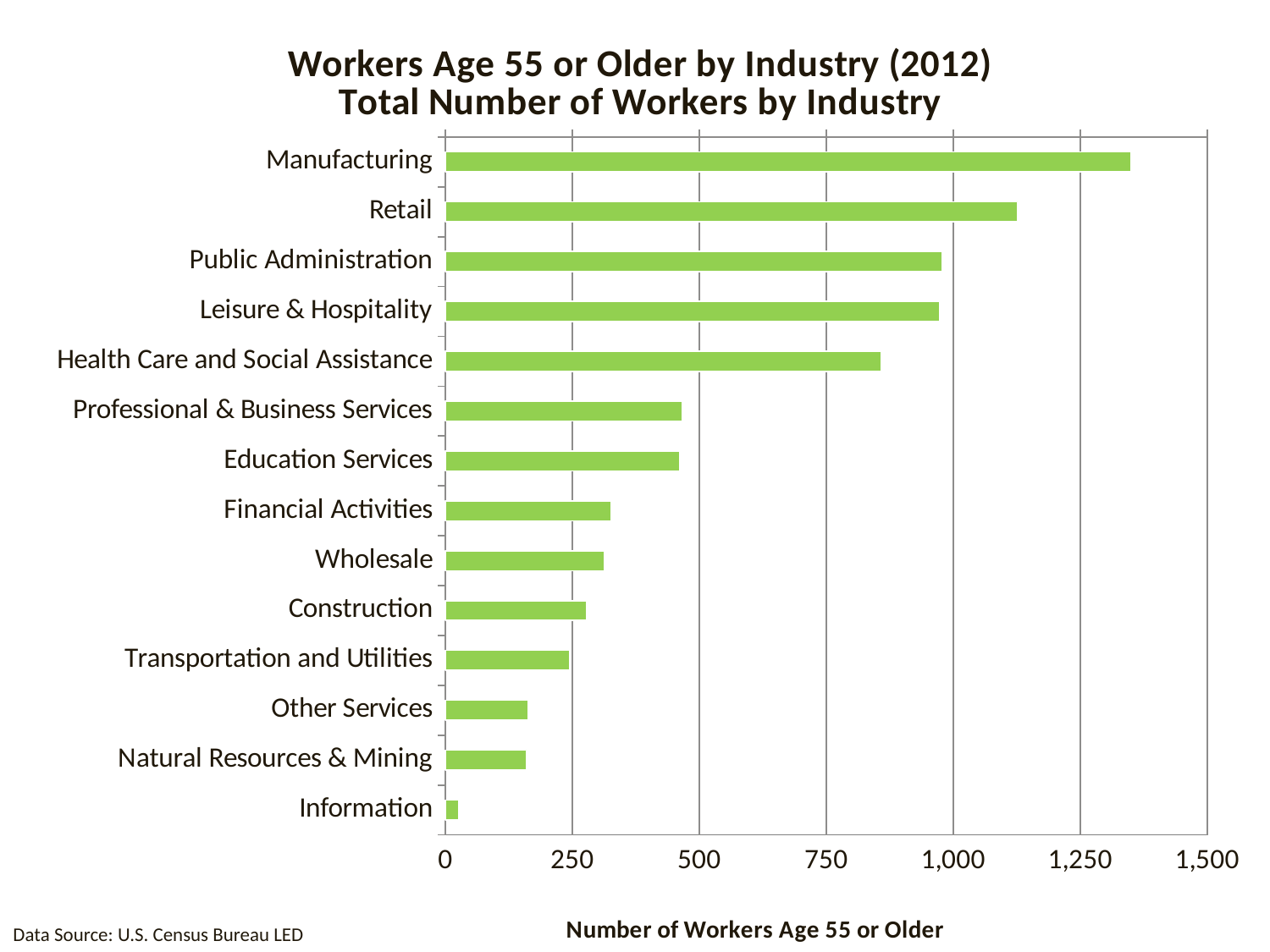
What is the label of the horizontal axis? Number of Workers Age 55 or Older Which industry has the highest number of workers age 55 or older? Manufacturing Is the value for Retail greater or less than 1,000? greater Is the value for Other Services greater or less than 250? less Is the value for Health Care and Social Assistance greater or less than 750? greater How many industries are shown in the chart? 14 Which industry has the lowest number of workers age 55 or older? Information What type of chart is shown on the slide? bar chart Which has more workers age 55 or older, Retail or Public Administration? Retail